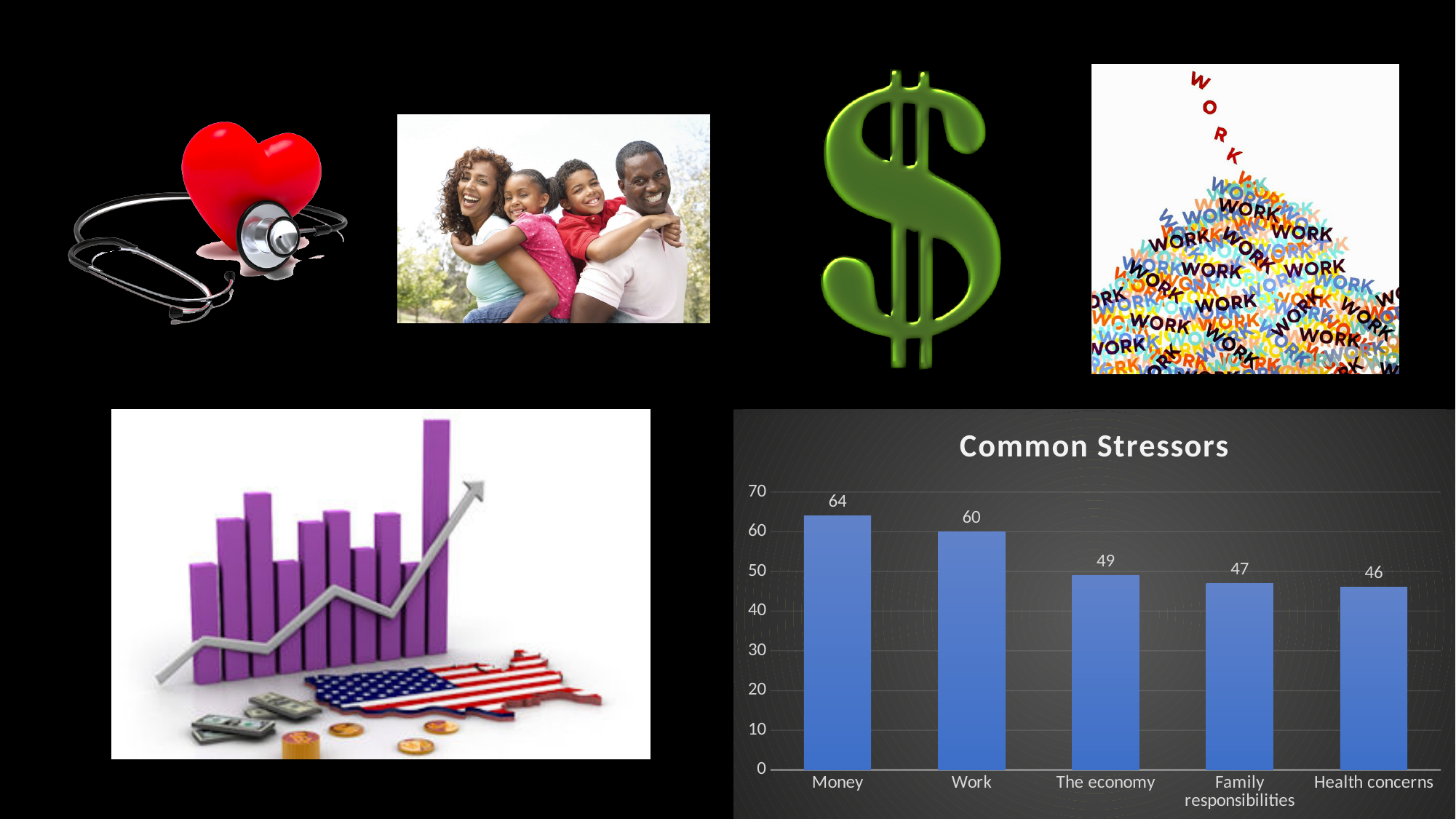
What is the value for Health concerns in the Common Stressors chart? 46 Is the value for Family responsibilities in the Common Stressors chart greater or less than 50? less What is the value for Money in the Common Stressors chart? 64 What is the value for The economy in the Common Stressors chart? 49 Which category has the highest value in the Common Stressors chart? Money How many categories are shown in the Common Stressors chart? 5 Which category has the lowest value in the Common Stressors chart? Health concerns Which is larger in the Common Stressors chart, the value for Work or the value for The economy? Work What kind of chart is the Common Stressors chart? bar chart What is the difference between the values for Money and Work in the Common Stressors chart? 4 What is the difference between the values for Work and Family responsibilities in the Common Stressors chart? 13 Do the values in the Common Stressors chart rise or fall from left to right along the x axis? fall